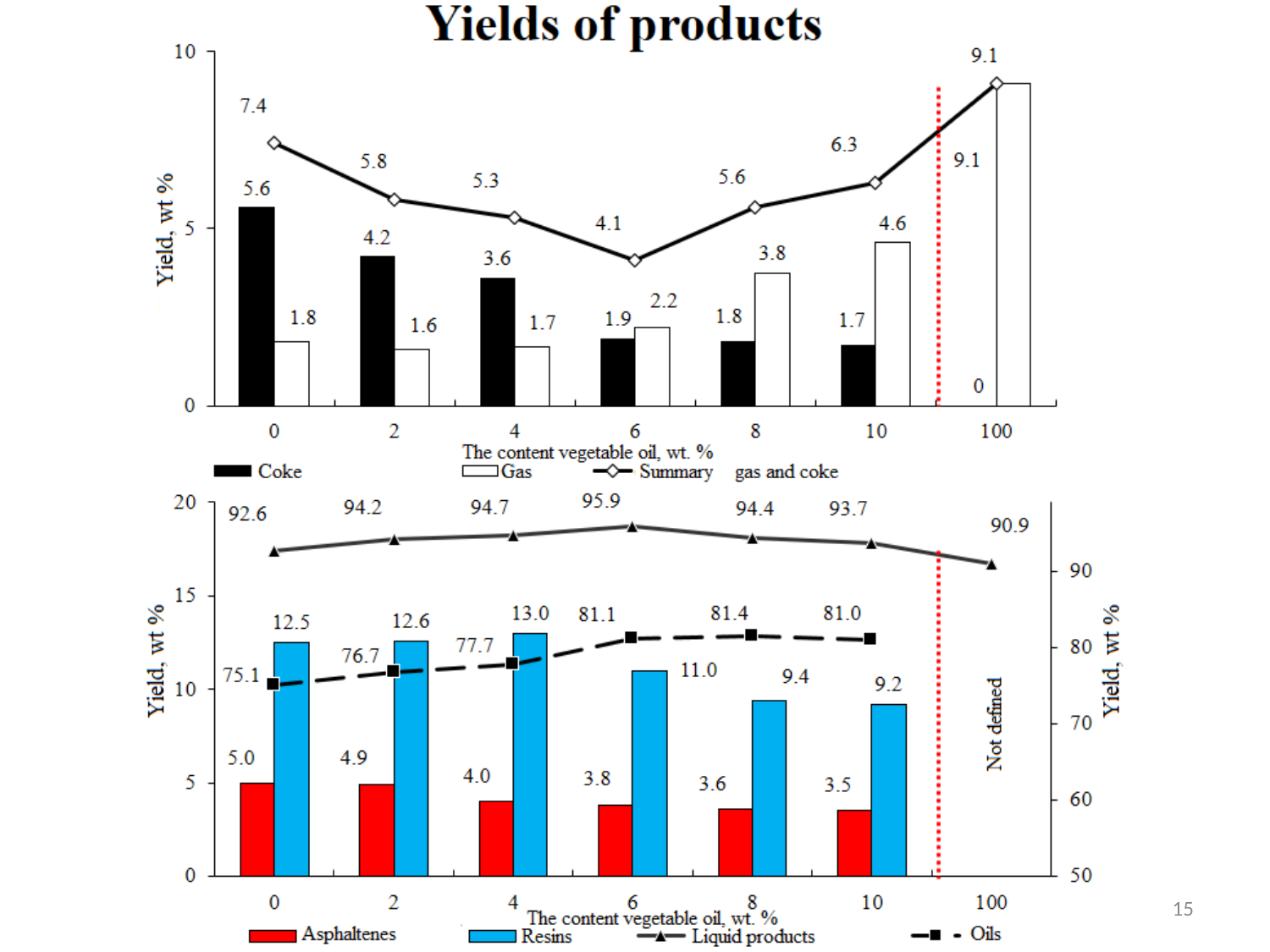
In the top chart, at which vegetable oil content is the Summary gas and coke value lowest? 6 In the bottom chart, do the Asphaltenes yields rise or fall as the vegetable oil content increases from 0 to 10 wt. %? fall In the top chart, what is the difference between the Summary gas and coke values at 0 and 2 wt. %? 1.6 In the top chart, which is larger at 8 wt. %: the Coke yield or the Gas yield? Gas In the top chart, what is the Gas yield at 10 wt. % vegetable oil content? 4.6 In the bottom chart, at which vegetable oil content is the Liquid products value highest? 6 In the top chart, how many series does the legend list? 3 In the bottom chart, what is the Oils value at 8 wt. % vegetable oil content? 81.4 In the top chart, what is the Coke yield at 0 wt. % vegetable oil content? 5.6 In the bottom chart, what is the Resins yield at 4 wt. % vegetable oil content? 13.0 In the bottom chart, what is the difference between the Asphaltenes yields at 0 and 10 wt. %? 1.5 In the bottom chart, what colour are the Resins bars? blue